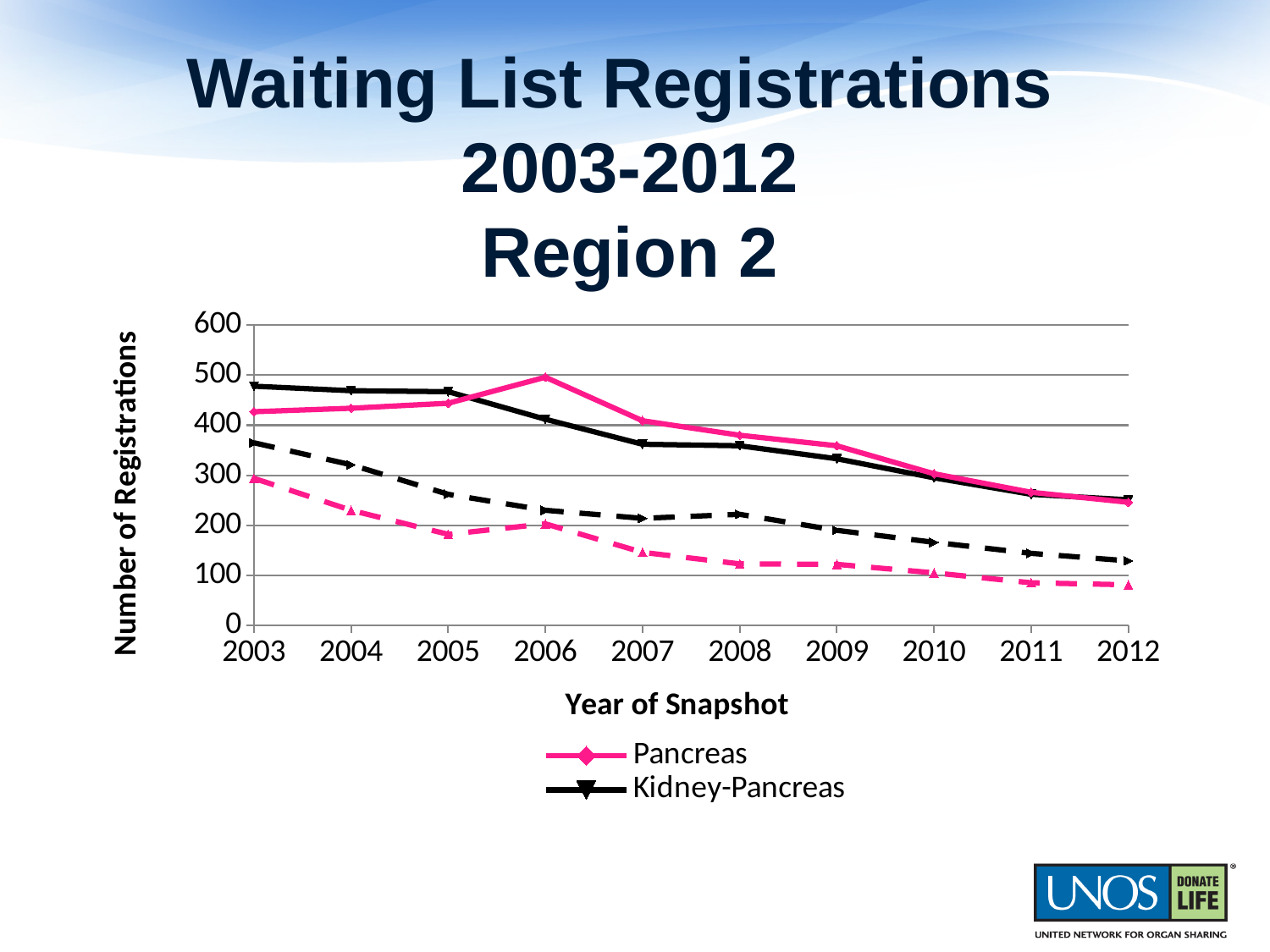
Does the Kidney-Pancreas series rise or fall from 2003 to 2012? fall Is the Pancreas value in 2012 greater or less than 300? less What kind of chart is shown on the slide? line chart How many years are shown on the x axis? 10 In which year does the Pancreas series reach its highest value? 2006 Is the Pancreas value in 2006 greater or less than 400? greater Is the Kidney-Pancreas value in 2007 greater or less than 400? less How many series does the legend list? 2 In 2006, which series has the higher value, Pancreas or Kidney-Pancreas? Pancreas In 2003, which series has the higher value, Pancreas or Kidney-Pancreas? Kidney-Pancreas In which year is the Kidney-Pancreas series at its lowest? 2012